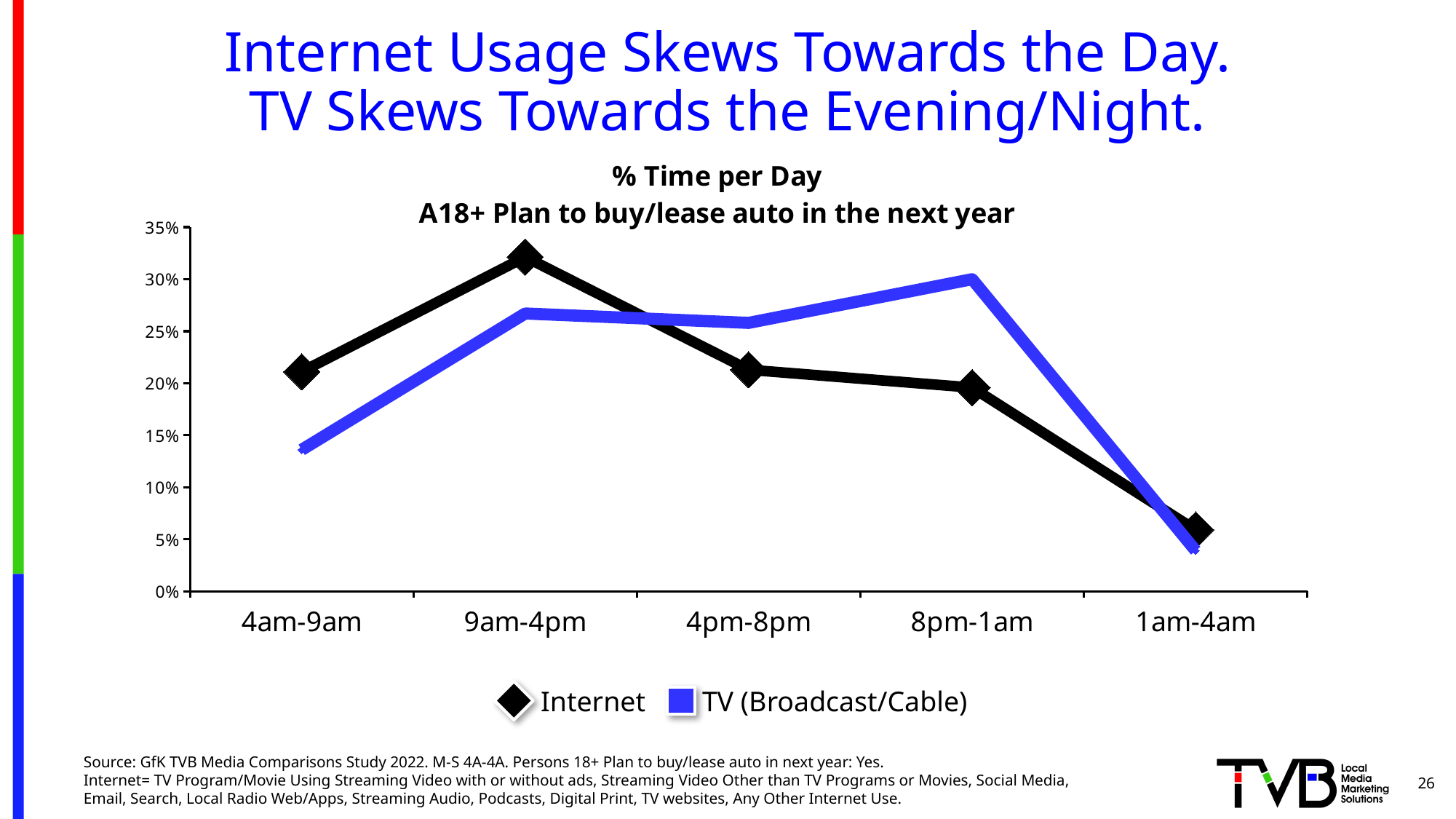
How many time periods are shown on the x axis? 5 For 4am-9am, which series has the larger value, Internet or TV (Broadcast/Cable)? Internet In which time period is the TV (Broadcast/Cable) value lowest? 1am-4am How many series does the legend list? 2 In which time period is the Internet value highest? 9am-4pm In which time period is the Internet value lowest? 1am-4am Is the Internet value for 9am-4pm greater or less than 30%? greater For 8pm-1am, which series has the larger value, Internet or TV (Broadcast/Cable)? TV (Broadcast/Cable) Is the TV (Broadcast/Cable) value for 4am-9am greater or less than 15%? less In which time period is the TV (Broadcast/Cable) value highest? 8pm-1am What kind of chart is shown on the slide? line chart What is the title of the chart? % Time per Day A18+ Plan to buy/lease auto in the next year